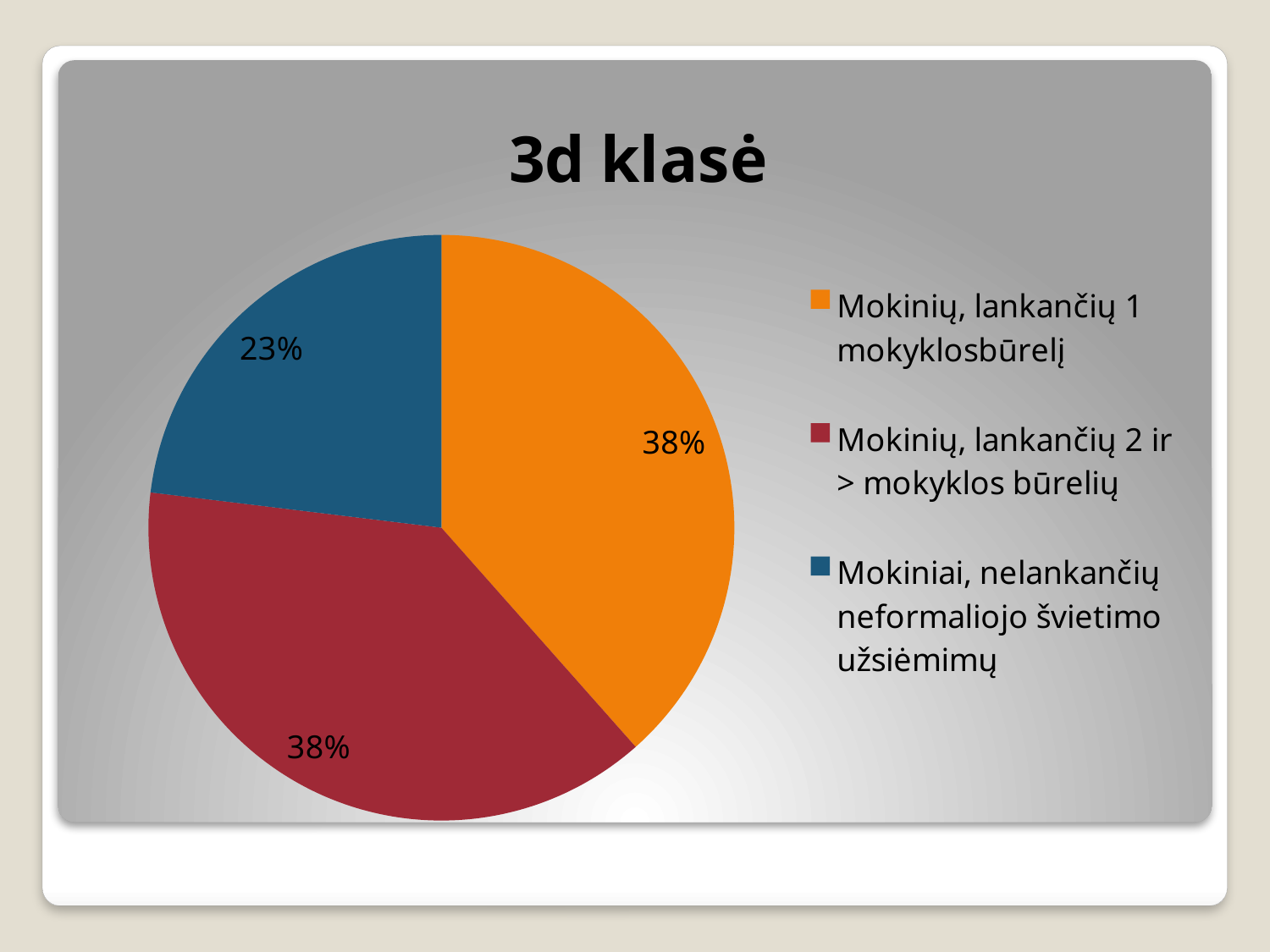
Which is larger: the share for "Mokinių, lankančių 1 mokyklosbūrelį" or the share for "Mokiniai, nelankančių neformaliojo švietimo užsiėmimų"? Mokinių, lankančių 1 mokyklosbūrelį What type of chart is shown on the slide? pie chart What percentage of the pie is labelled for "Mokinių, lankančių 1 mokyklosbūrelį"? 38% What percentage of the pie is labelled for "Mokinių, lankančių 2 ir > mokyklos būrelių"? 38% What is the difference in percentage points between the share for "Mokinių, lankančių 2 ir > mokyklos būrelių" and the share for "Mokiniai, nelankančių neformaliojo švietimo užsiėmimų"? 15 What colour is the slice for "Mokiniai, nelankančių neformaliojo švietimo užsiėmimų"? blue What percentage of the pie is labelled for "Mokiniai, nelankančių neformaliojo švietimo užsiėmimų"? 23% What is the title of the chart? 3d klasė What share of the pie does the blue slice represent? 23% How many entries does the legend list? 3 Which category has the smallest share of the pie? Mokiniai, nelankančių neformaliojo švietimo užsiėmimų How many slices does the pie chart have? 3